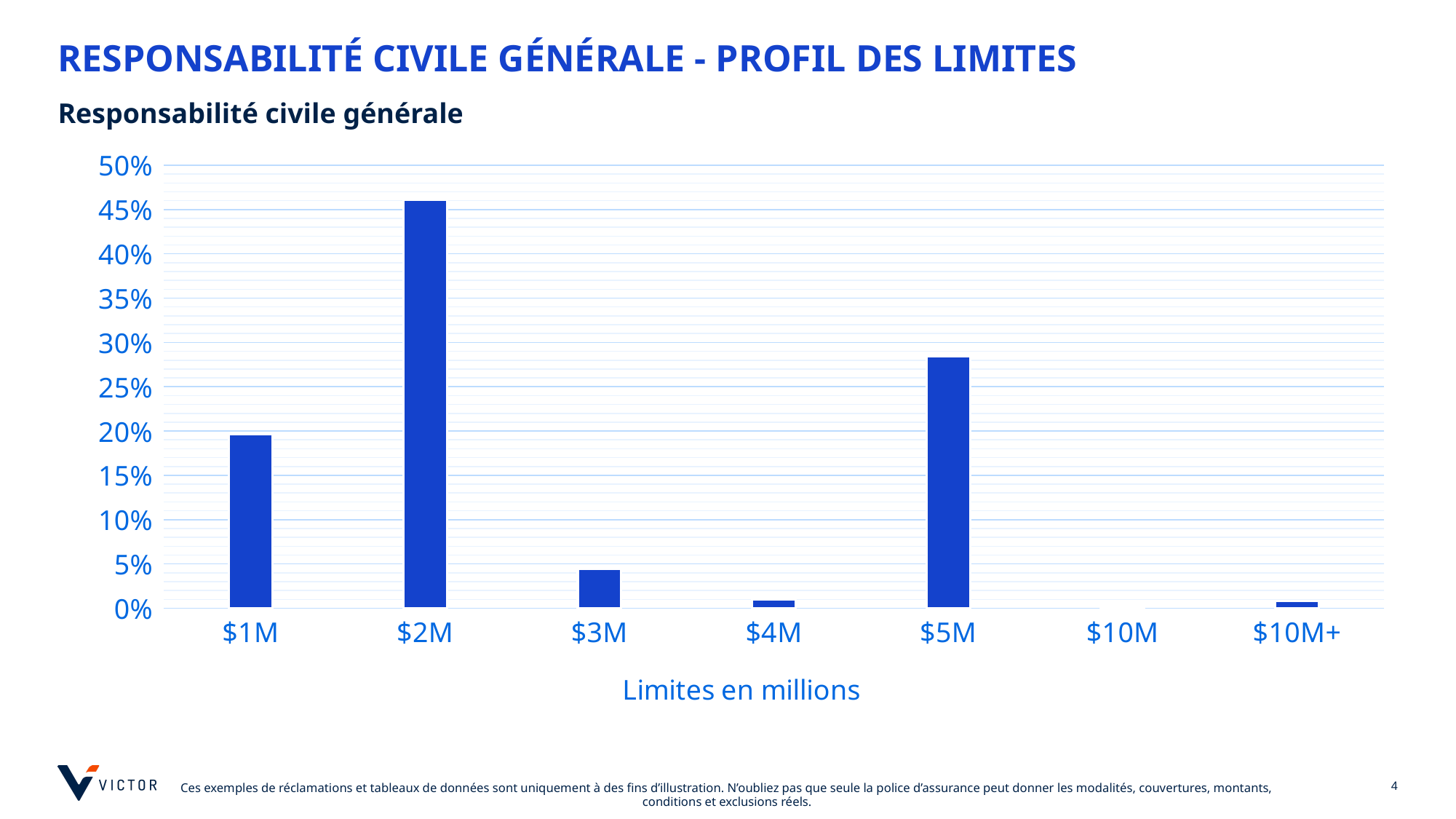
Is the value for $1M greater or less than 15%? greater Which has a larger value, $3M or $4M? $3M Which limit category has the lowest value? $10M Is the value for $5M greater or less than 30%? less Is the value for $2M greater or less than 40%? greater Which has a larger value, $1M or $5M? $5M What is the title of the x axis? Limites en millions Which limit category has the highest value? $2M What kind of chart is shown on the slide? bar chart How many limit categories are shown on the x axis? 7